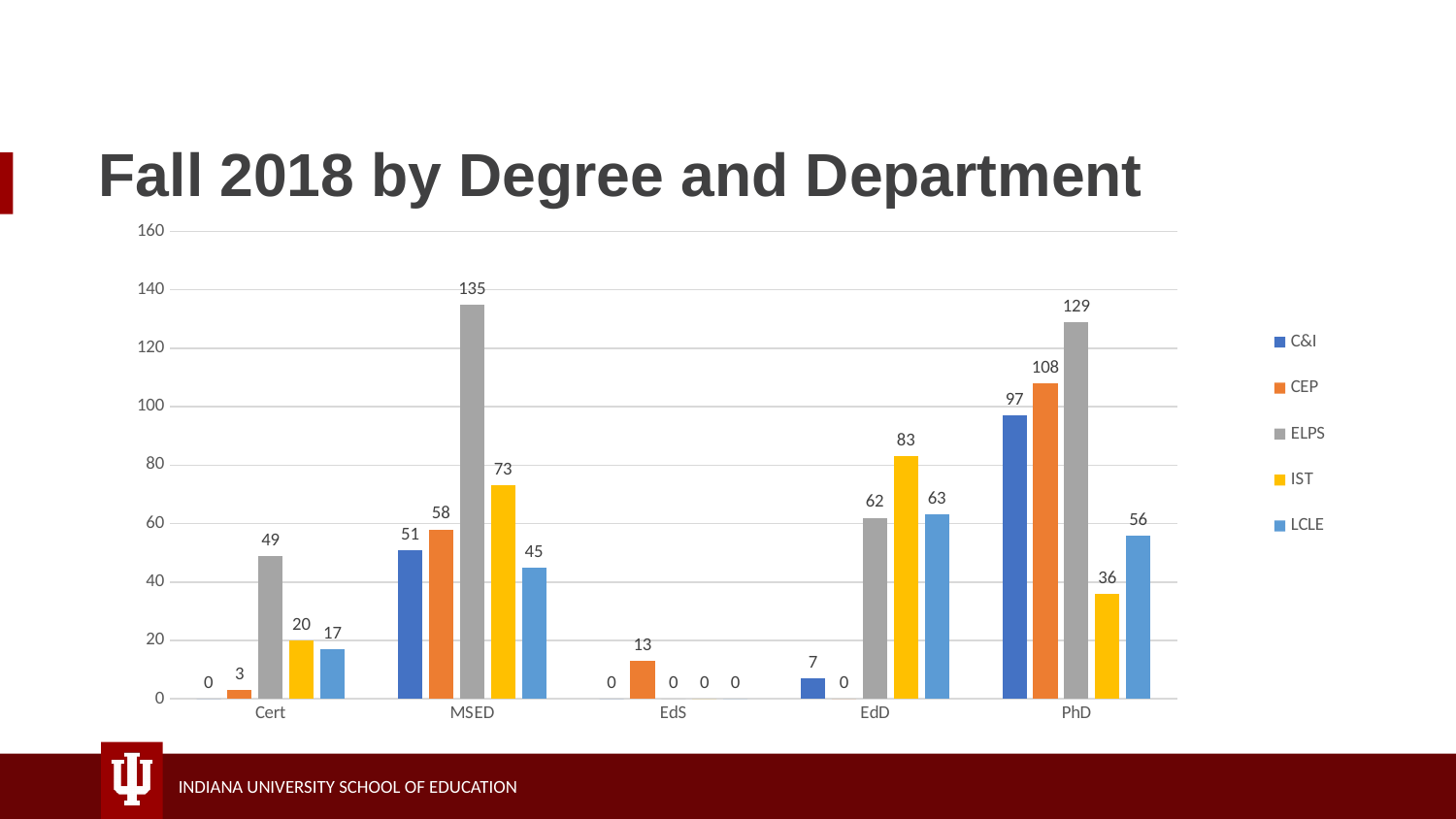
What is the value for CEP in the PhD category? 108 What kind of chart is shown on the slide? Bar chart Is the value for ELPS in the PhD category greater or less than 120? greater Which department has the lowest value in the Cert category? C&I How many degree categories are shown on the x axis? 5 What is the title of the slide? Fall 2018 by Degree and Department What is the value for IST in the EdD category? 83 Which department has the highest value in the PhD category? ELPS What is the difference between the ELPS and C&I values in the MSED category? 84 How many series does the legend list? 5 In the EdD category, which is larger: the value for LCLE or the value for ELPS? LCLE What is the value for ELPS in the MSED category? 135